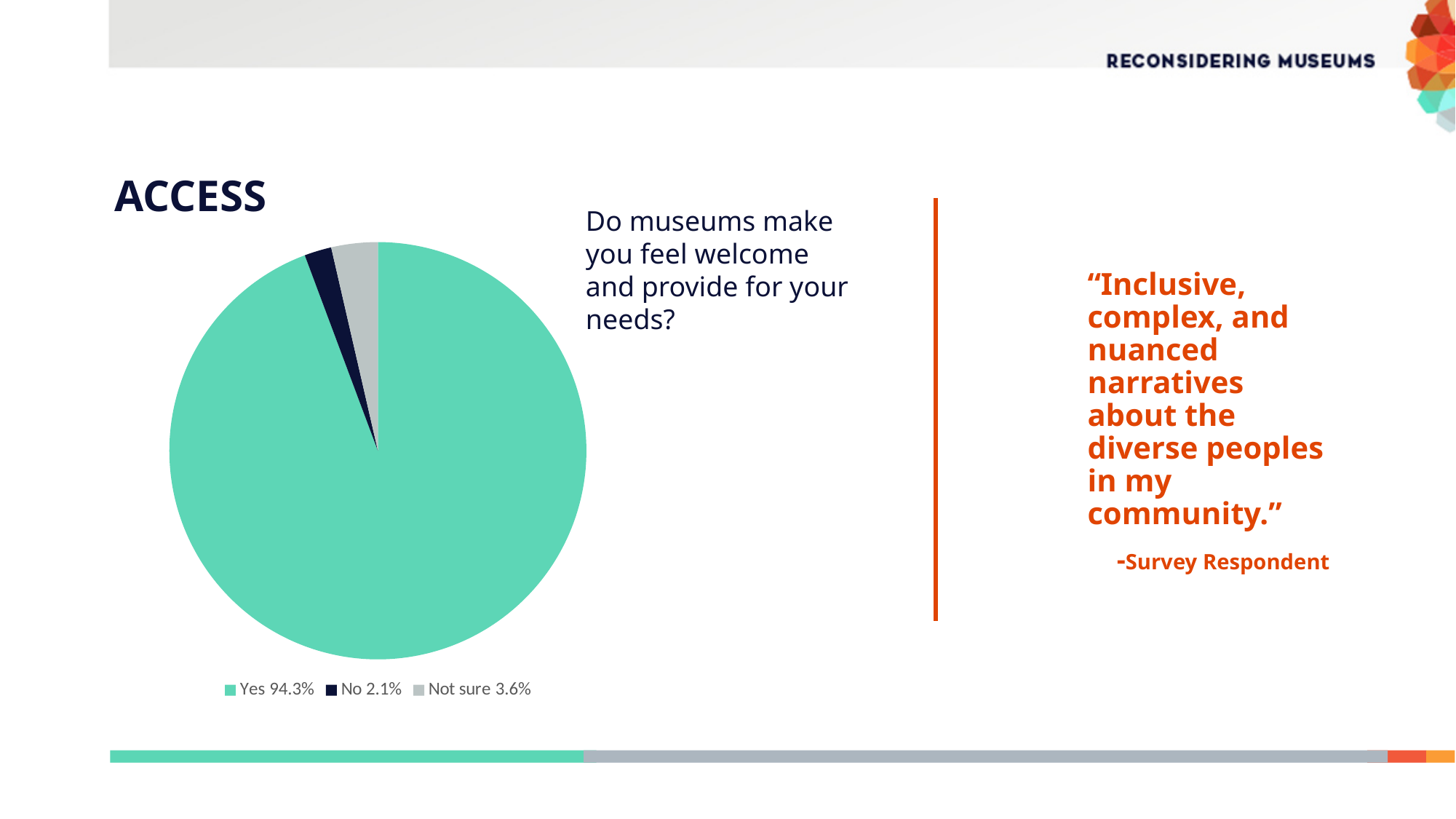
What share of respondents answered No? 2.1% What colour is the Yes slice of the pie chart? green (teal) What is the difference between the Yes share and the Not sure share? 90.7% What share of respondents answered Yes? 94.3% What is the difference between the Not sure share and the No share? 1.5% Which is larger, the share for No or the share for Not sure? Not sure What kind of chart is shown on the slide? pie chart What share of respondents answered Not sure? 3.6% Which response has the largest slice of the pie? Yes How many slices does the pie chart have? 3 Which response has the smallest slice of the pie? No What question does the pie chart report responses to? Do museums make you feel welcome and provide for your needs?